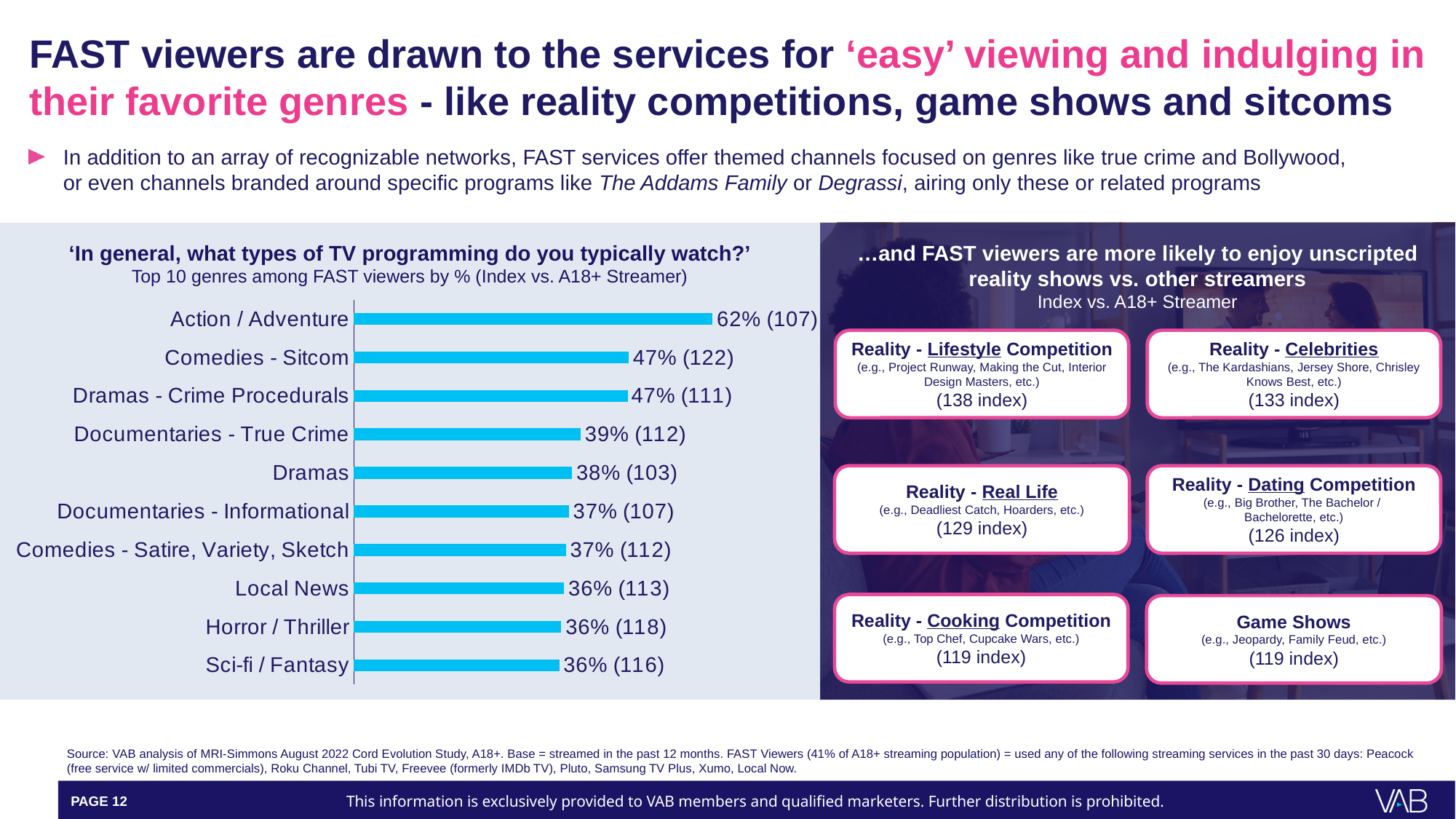
Which genre has the highest index value in the bar chart? Comedies - Sitcom Which genre has the highest percentage in the bar chart? Action / Adventure What percentage of FAST viewers typically watch Action / Adventure programming? 62% What percentage is shown for Documentaries - True Crime? 39% What is the difference in percentage points between Action / Adventure and Dramas? 24 What is the index value shown for Comedies - Sitcom? 122 What type of chart is used to show the top 10 genres among FAST viewers? Bar chart What is the index value shown for Horror / Thriller? 118 Do the percentage values rise or fall moving from the top bar to the bottom bar? Fall Which has a higher percentage, Documentaries - True Crime or Local News? Documentaries - True Crime How many genres are shown in the bar chart? 10 What colour are the bars in the chart? Light blue